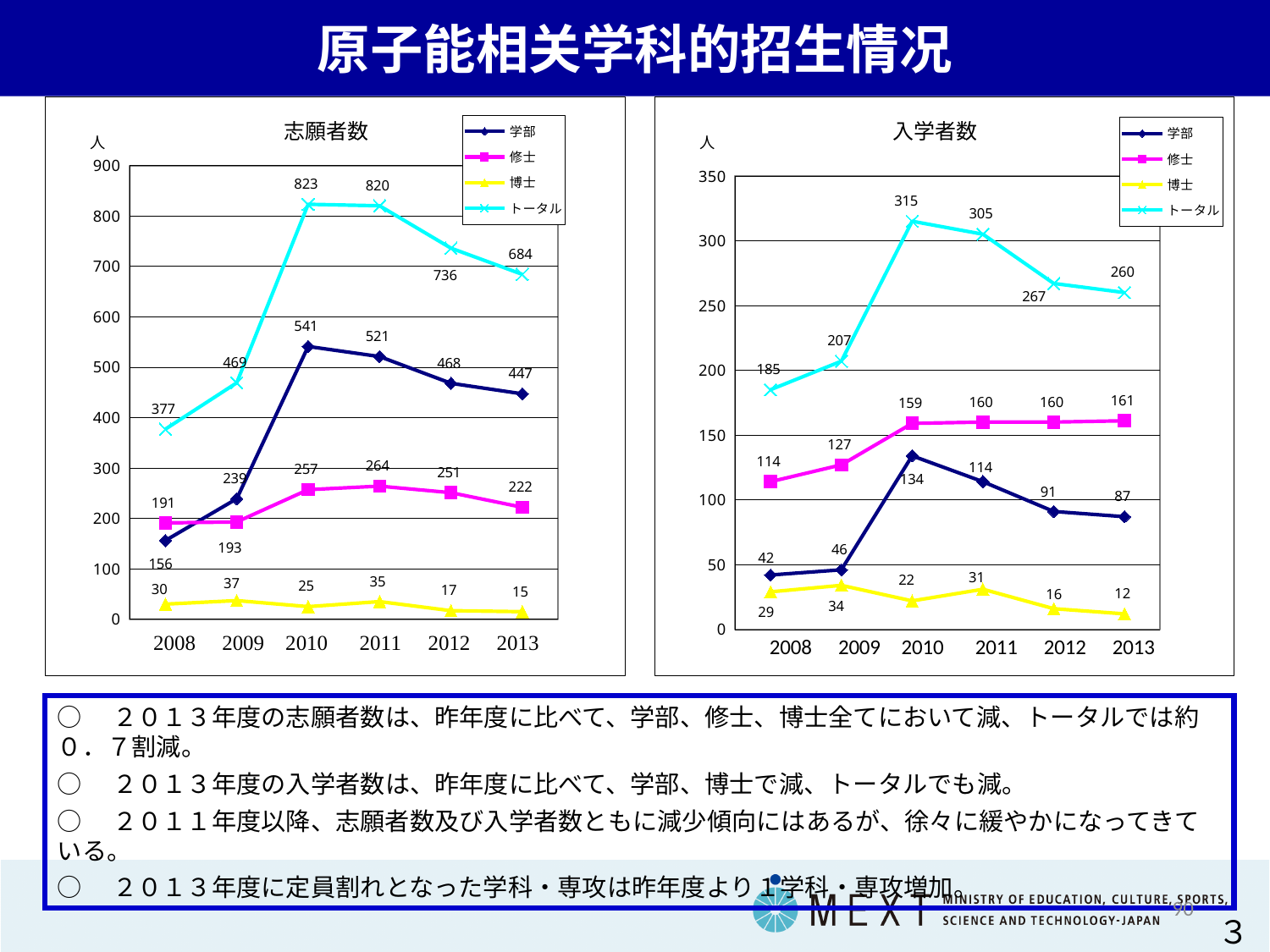
In the 入学者数 chart, which year has the highest 学部 value? 2010 In the 志願者数 chart, what is the 学部 value for 2013? 447 In the 入学者数 chart, what is the difference between the トータル values for 2010 and 2011? 10 In the 志願者数 chart, which year has the highest 修士 value? 2011 In the 入学者数 chart, which is larger in 2012: the 学部 value or the 修士 value? 修士 How many series does the legend of the 入学者数 chart list? 4 What kind of chart is the 志願者数 chart? Line chart In the 入学者数 chart, what is the 修士 value for 2013? 161 In the 志願者数 chart, what is the トータル value for 2010? 823 How many years are plotted on the x axis of the 志願者数 chart? 6 In the 志願者数 chart, which year has the lowest 博士 value? 2013 In the 志願者数 chart, what is the difference between the トータル values for 2012 and 2013? 52